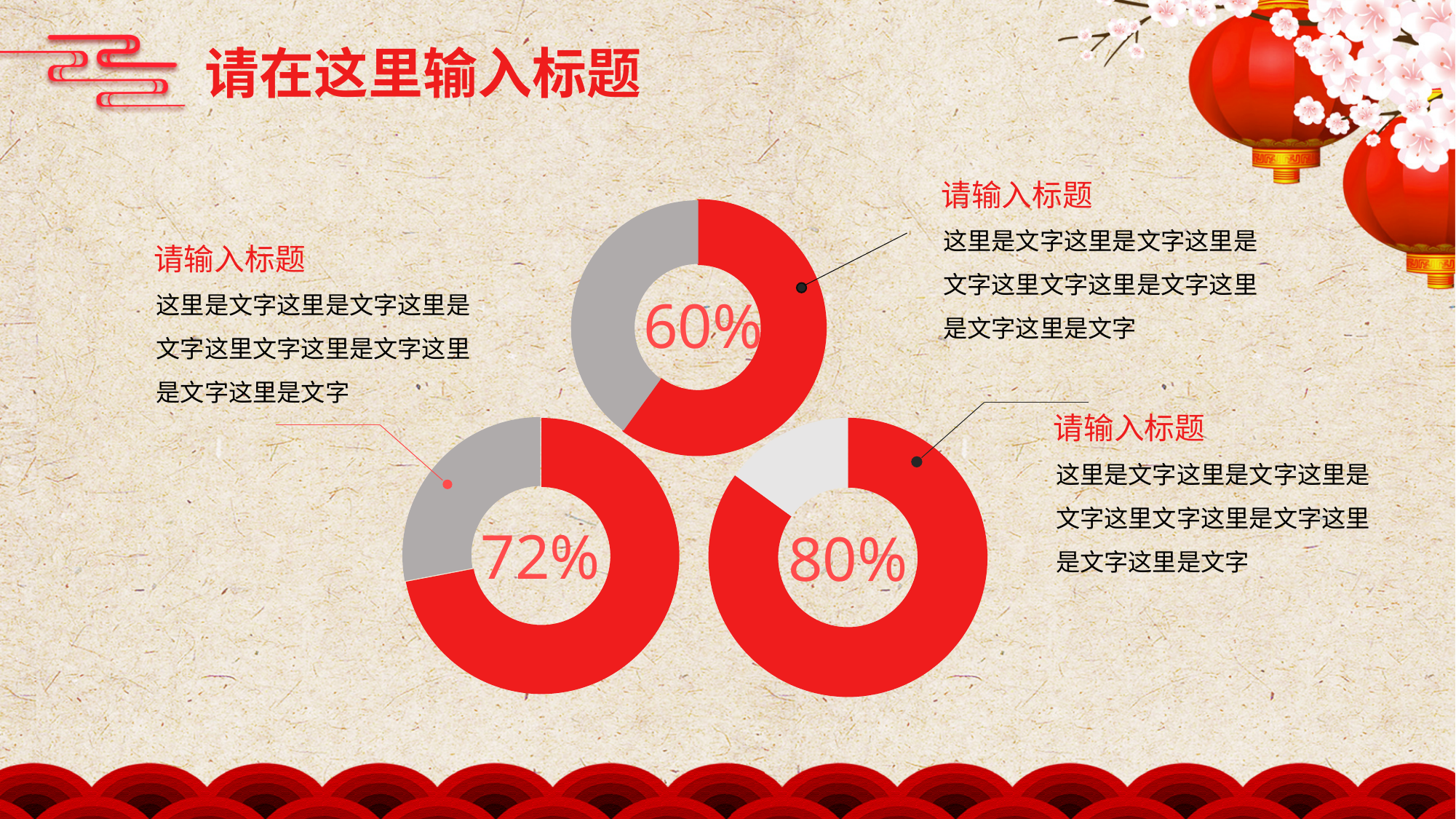
How many donut charts are on the slide? 3 What is the difference between the percentage in the bottom-right donut and the percentage in the top donut? 20 percentage points Which of the three donut charts shows the lowest percentage? The top donut (60%) Is the value shown in the bottom-right donut chart greater or less than 75%? greater What kind of chart is used to display the percentages on this slide? Donut (pie) chart Which shows a larger percentage, the bottom-left donut or the top donut? The bottom-left donut What colour is the filled (percentage) portion of each donut chart? Red What percentage is shown in the centre of the top donut chart? 60% What is the difference between the percentage in the bottom-left donut and the percentage in the top donut? 12 percentage points What percentage is shown in the centre of the bottom-right donut chart? 80% Which of the three donut charts shows the highest percentage? The bottom-right donut (80%) What percentage is shown in the centre of the bottom-left donut chart? 72%